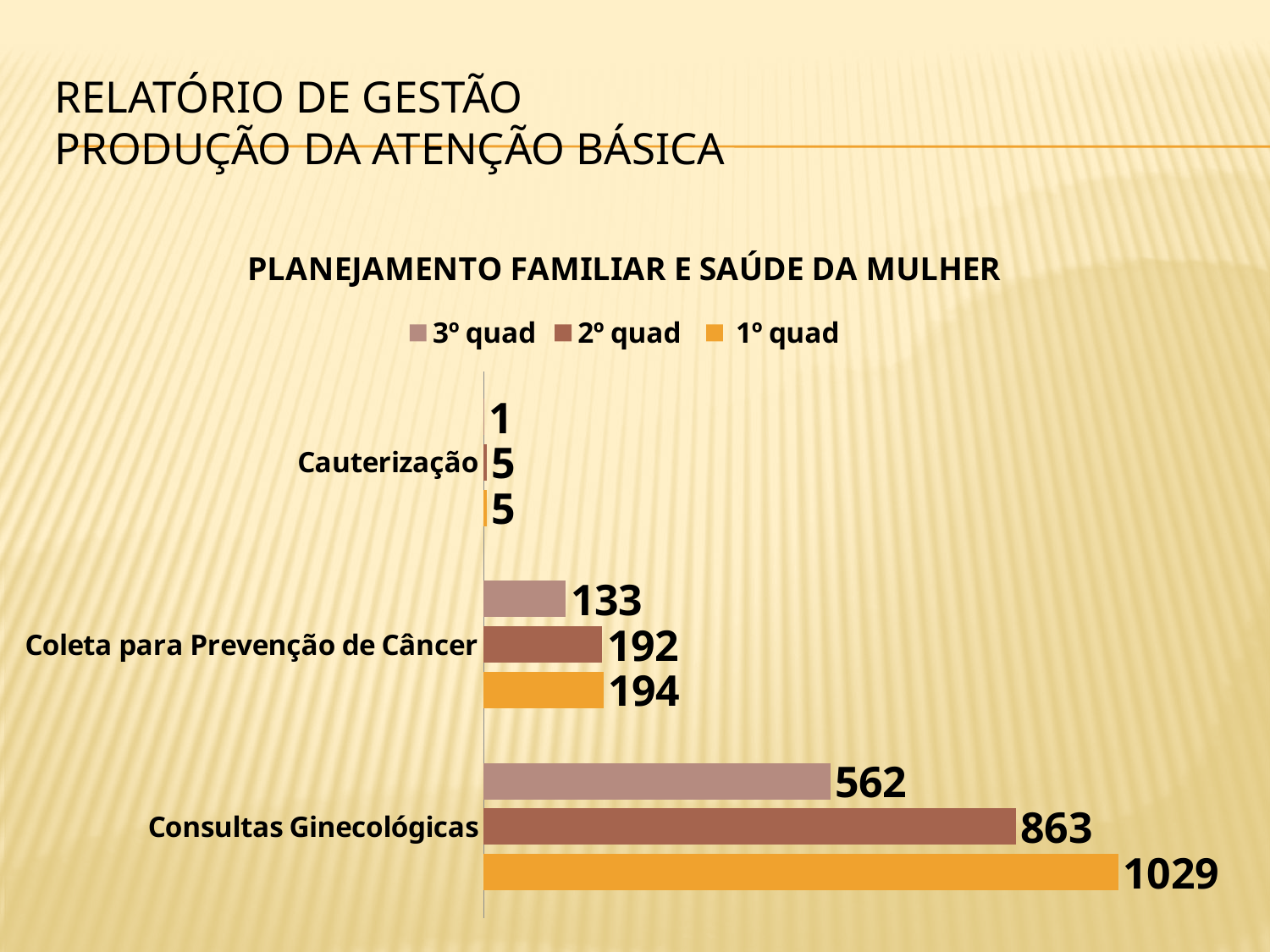
Which category has the highest value in the 2º quad series? Consultas Ginecológicas For Consultas Ginecológicas, which is larger: the 2º quad value or the 3º quad value? 2º quad How many categories are shown on the chart? 3 What is the value for Cauterização in the 2º quad series? 5 Which category has the lowest value in the 1º quad series? Cauterização What is the difference between the 1º quad and 3º quad values for Consultas Ginecológicas? 467 What is the title of the chart? PLANEJAMENTO FAMILIAR E SAÚDE DA MULHER What is the difference between the 2º quad and 3º quad values for Coleta para Prevenção de Câncer? 59 What is the value for Consultas Ginecológicas in the 1º quad series? 1029 How many series does the legend list? 3 What is the value for Coleta para Prevenção de Câncer in the 3º quad series? 133 What kind of chart is shown on the slide? Bar chart